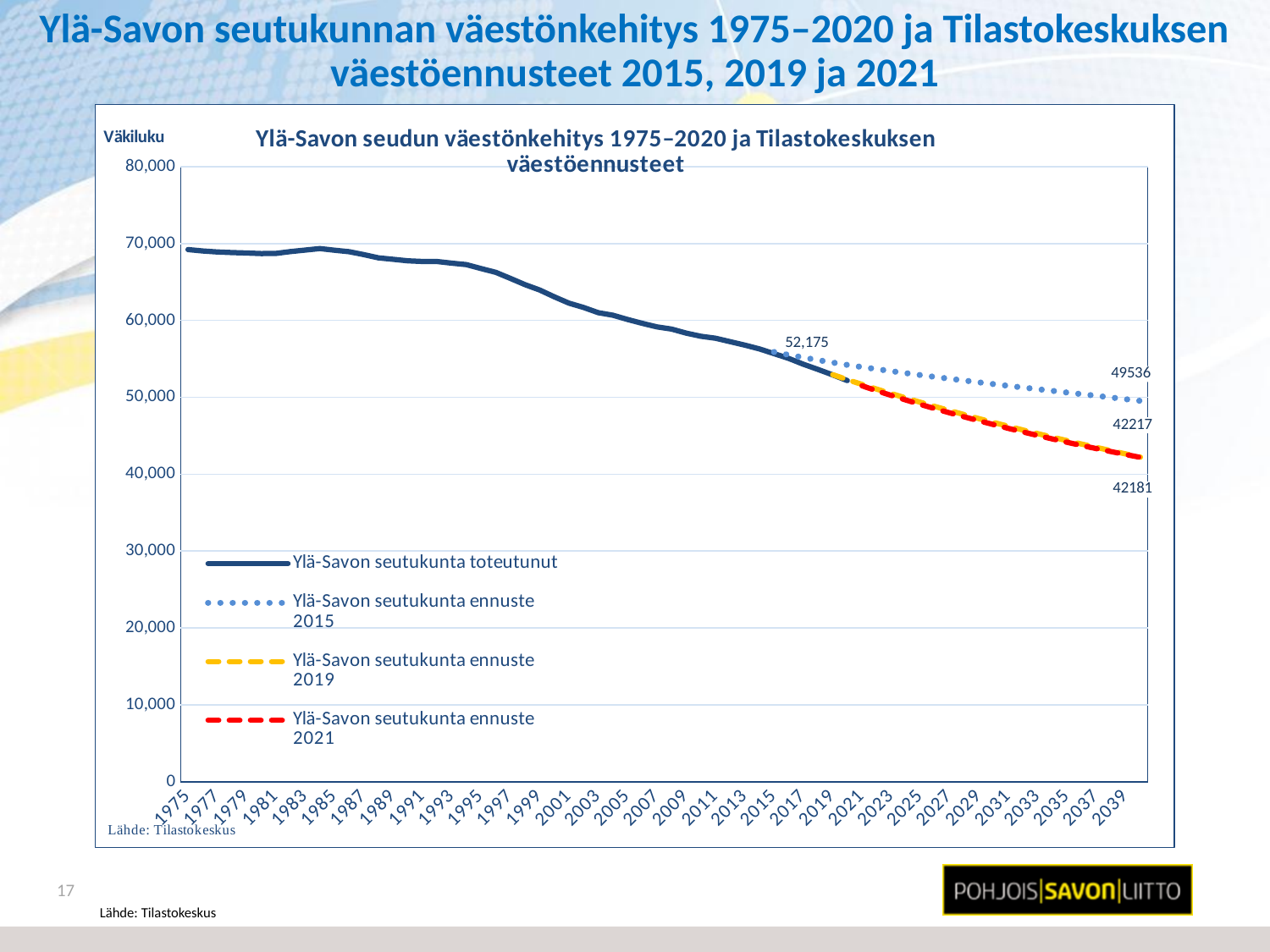
What type of chart is shown on the slide? line chart Is the value of the 'Ylä-Savon seutukunta toteutunut' series in 1975 greater or less than 60,000? greater What is the label shown on the vertical axis of the chart? Väkiluku What is the difference between the final labelled values of the 2019 forecast (42217) and the 2021 forecast (42181)? 36 What is the final labelled value of the 'Ylä-Savon seutukunta ennuste 2019' series? 42217 Which forecast series ends at the highest value at the right end of the chart? Ylä-Savon seutukunta ennuste 2015 How many series does the legend list? 4 Does the 'Ylä-Savon seutukunta toteutunut' series rise or fall from 1975 to 2020? fall What is the difference between the final labelled values of the 2015 forecast (49536) and the 2021 forecast (42181)? 7355 What is the final labelled value of the 'Ylä-Savon seutukunta ennuste 2015' series? 49536 What is the final labelled value of the 'Ylä-Savon seutukunta ennuste 2021' series? 42181